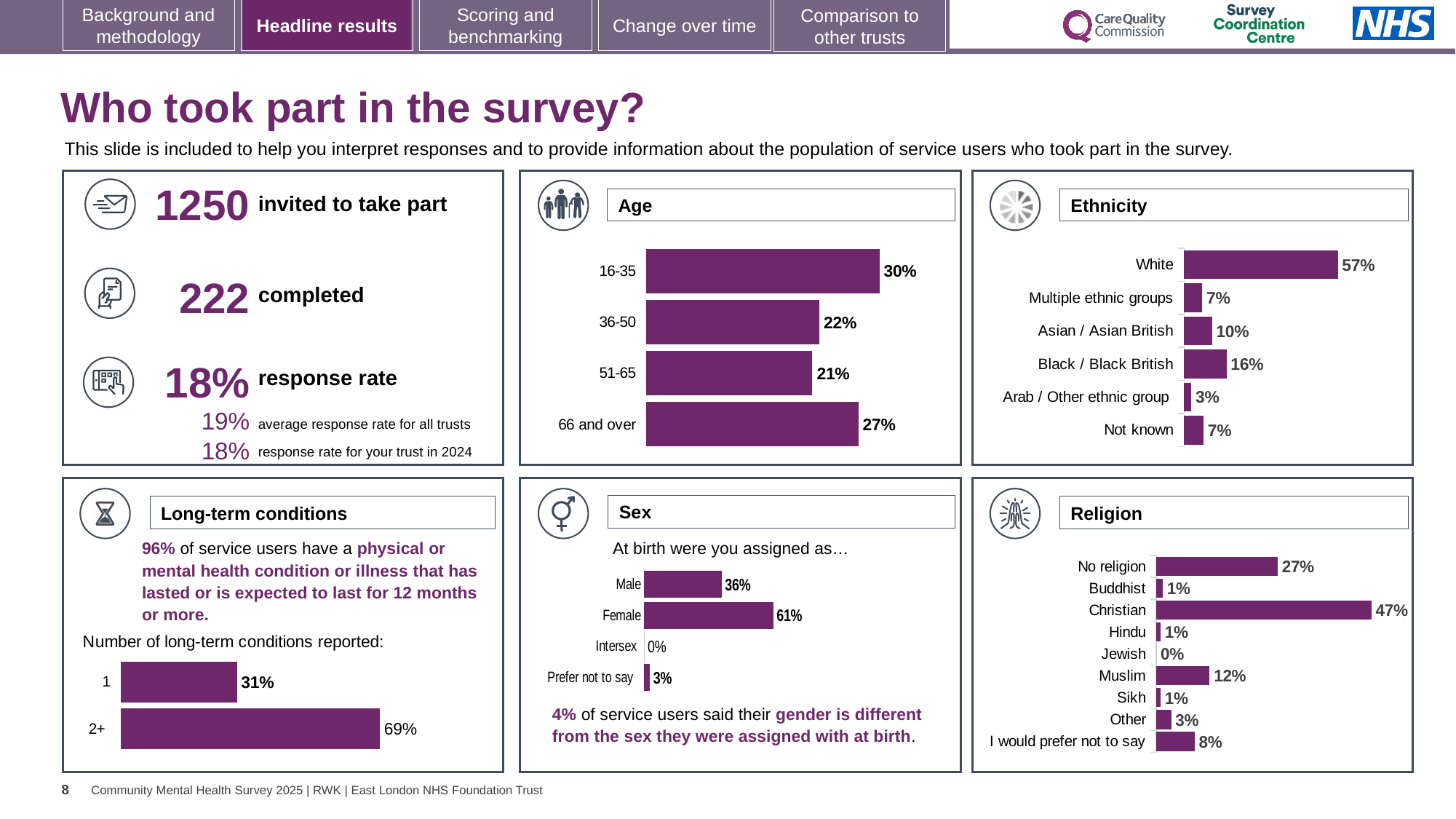
In the Religion chart, which category has the highest value? Christian In the Age chart, which age group has the lowest percentage? 51-65 In the Ethnicity chart, what is the difference between White and Asian / Asian British? 47% In the Ethnicity chart, how many categories are shown? 6 What kind of chart is the Age chart? Bar chart In the Age chart, what percentage of respondents were aged 16-35? 30% In the Ethnicity chart, what is the value for Black / Black British? 16% In the Sex chart, which is larger, Male or Female? Female In the Religion chart, what is the value for Muslim? 12% In the Ethnicity chart, which category has the highest value? White In the Sex chart, what percentage of respondents were assigned Female at birth? 61% In the Long-term conditions chart, what percentage reported 2+ conditions? 69%